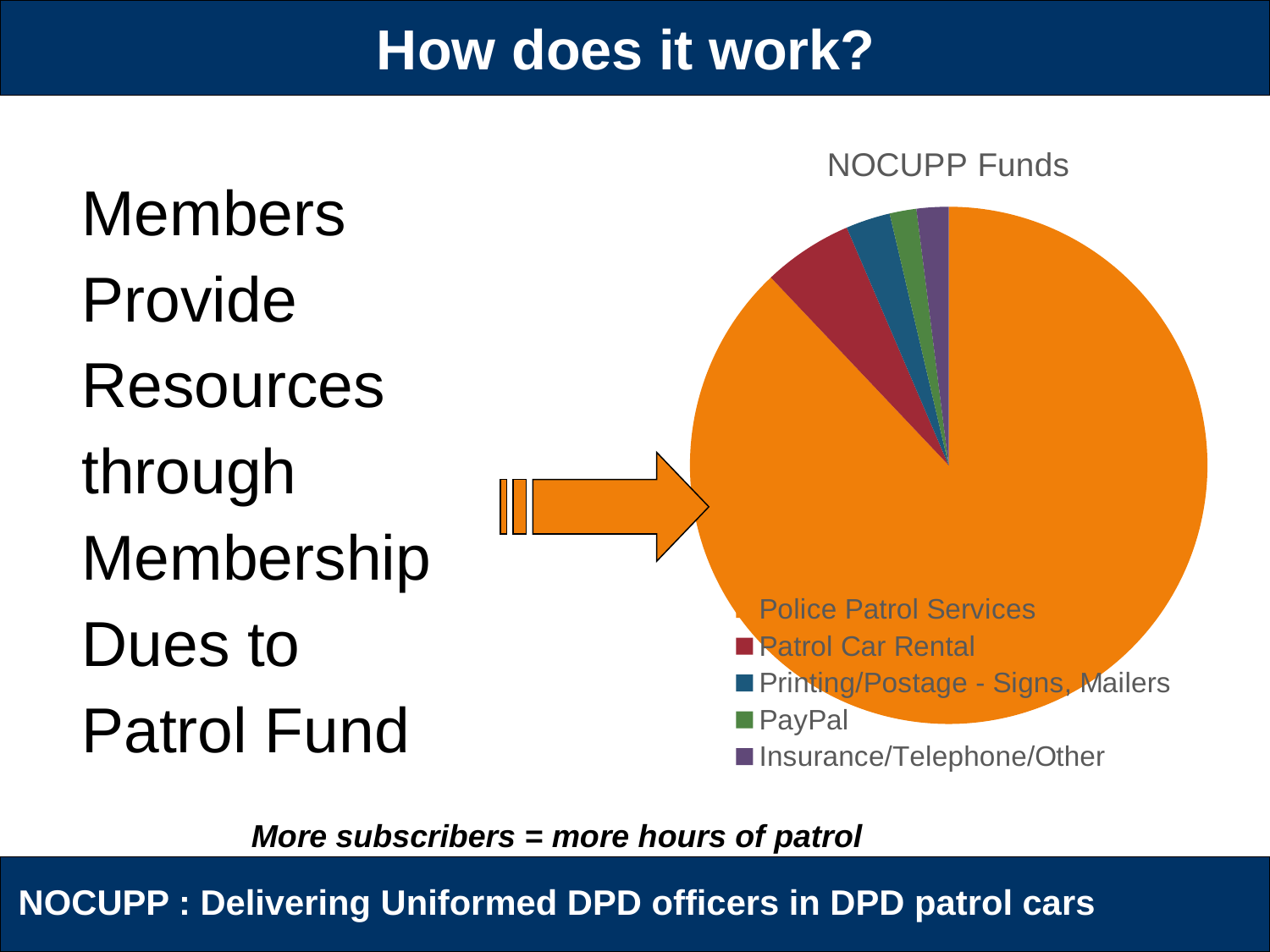
How many categories does the pie chart's legend list? 5 Which is larger, the slice for Police Patrol Services or the slice for Patrol Car Rental? Police Patrol Services Which is larger, the slice for Police Patrol Services or the slice for Insurance/Telephone/Other? Police Patrol Services Which category has the largest slice of the pie? Police Patrol Services Which category is the second-largest slice of the pie? Patrol Car Rental Which is larger, the slice for Patrol Car Rental or the slice for Printing/Postage - Signs, Mailers? Patrol Car Rental What is the title of the chart? NOCUPP Funds What kind of chart is shown on the slide? pie chart What colour is the slice for Police Patrol Services? orange